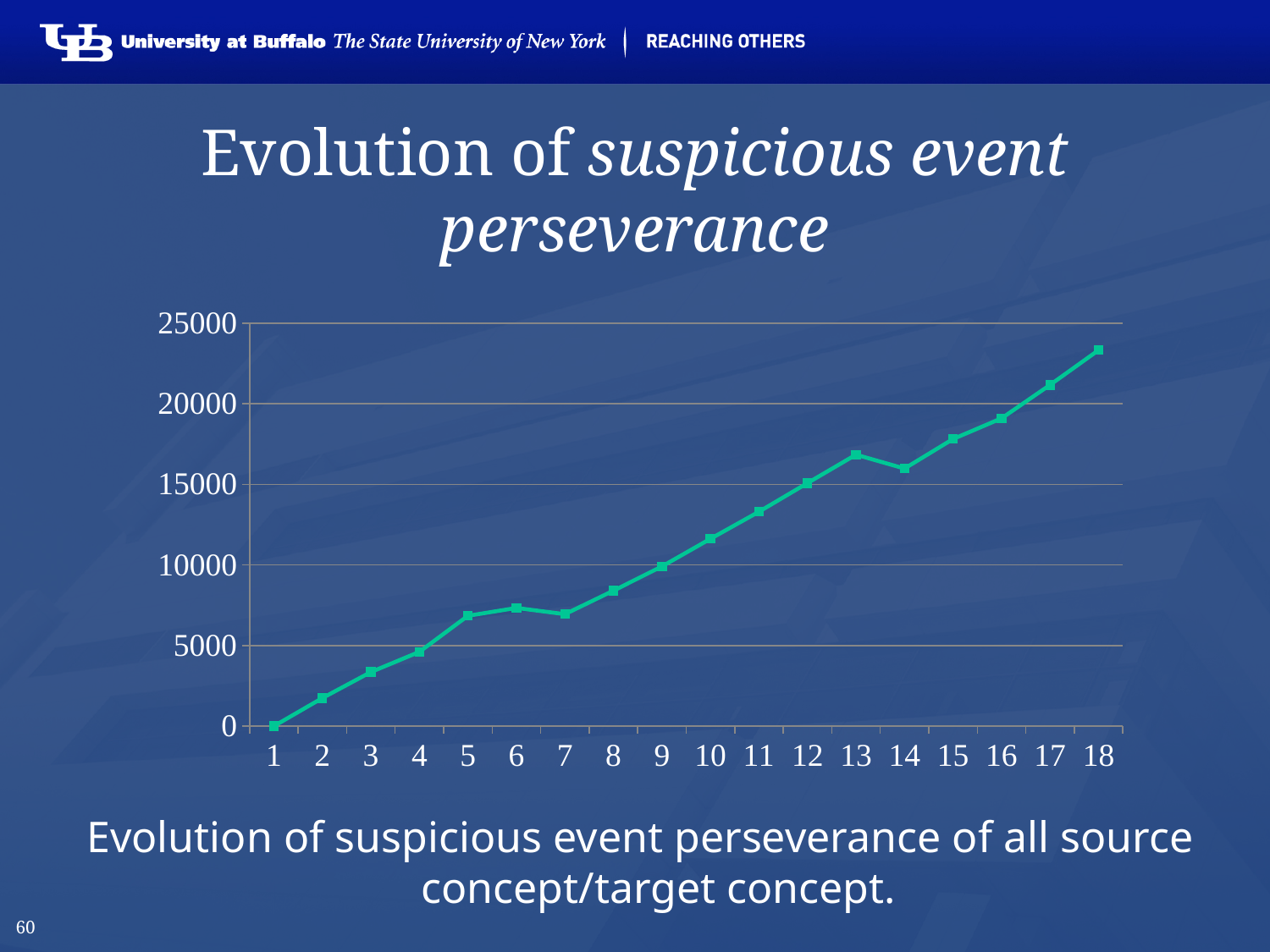
Which x-axis point has the lowest value? 1 How many points are plotted along the x axis? 18 Which has the larger value, point 13 or point 14? 13 What kind of chart is shown on the slide? line chart Is the value at point 16 greater or less than 20000? less Is the value at point 10 greater or less than 10000? greater Is the value at point 3 greater or less than 5000? less Which x-axis point has the highest value? 18 What is the value at point 1? 0 Do the values generally rise or fall from point 1 to point 18? rise